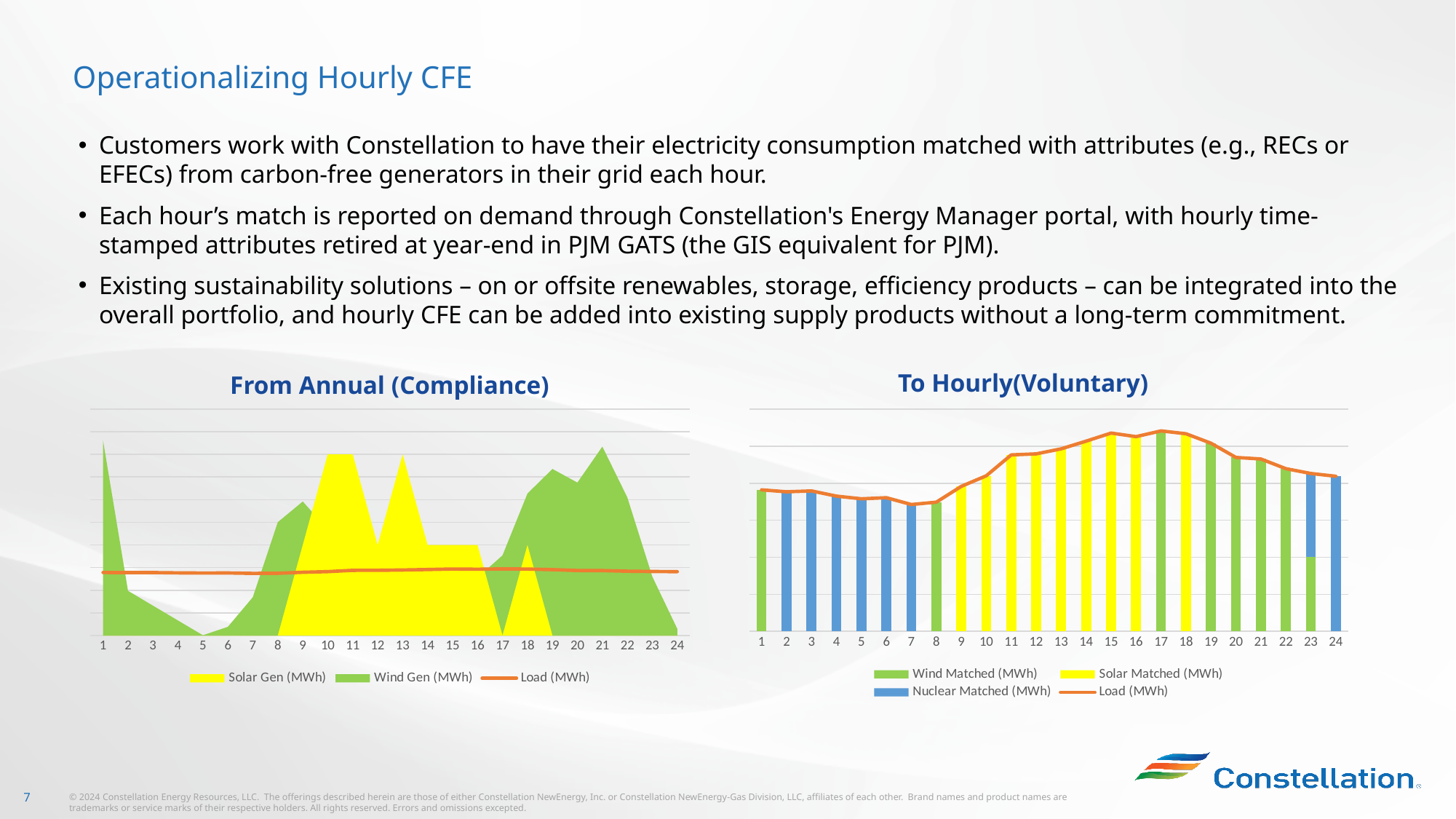
In the "To Hourly(Voluntary)" chart, does the Load (MWh) line rise or fall from hour 17 to hour 24? Fall What kind of chart is the "From Annual (Compliance)" chart? Area and line chart In the "From Annual (Compliance)" chart, which series is drawn as an orange line? Load (MWh) In the "To Hourly(Voluntary)" chart, is the bar at hour 15 taller or shorter than the bar at hour 1? Taller How many hours are shown on the x axis of the "To Hourly(Voluntary)" chart? 24 How many points are plotted along the x axis of the "From Annual (Compliance)" chart? 24 How many series does the legend of the "From Annual (Compliance)" chart list? 3 In the "To Hourly(Voluntary)" chart, does the Load (MWh) line rise or fall from hour 7 to hour 15? Rise In the "To Hourly(Voluntary)" chart, which series is shown in blue? Nuclear Matched (MWh) What kind of chart is the "To Hourly(Voluntary)" chart? Bar and line chart How many series does the legend of the "To Hourly(Voluntary)" chart list? 4 In the "To Hourly(Voluntary)" chart, which hour has the lowest Load (MWh) value? 7